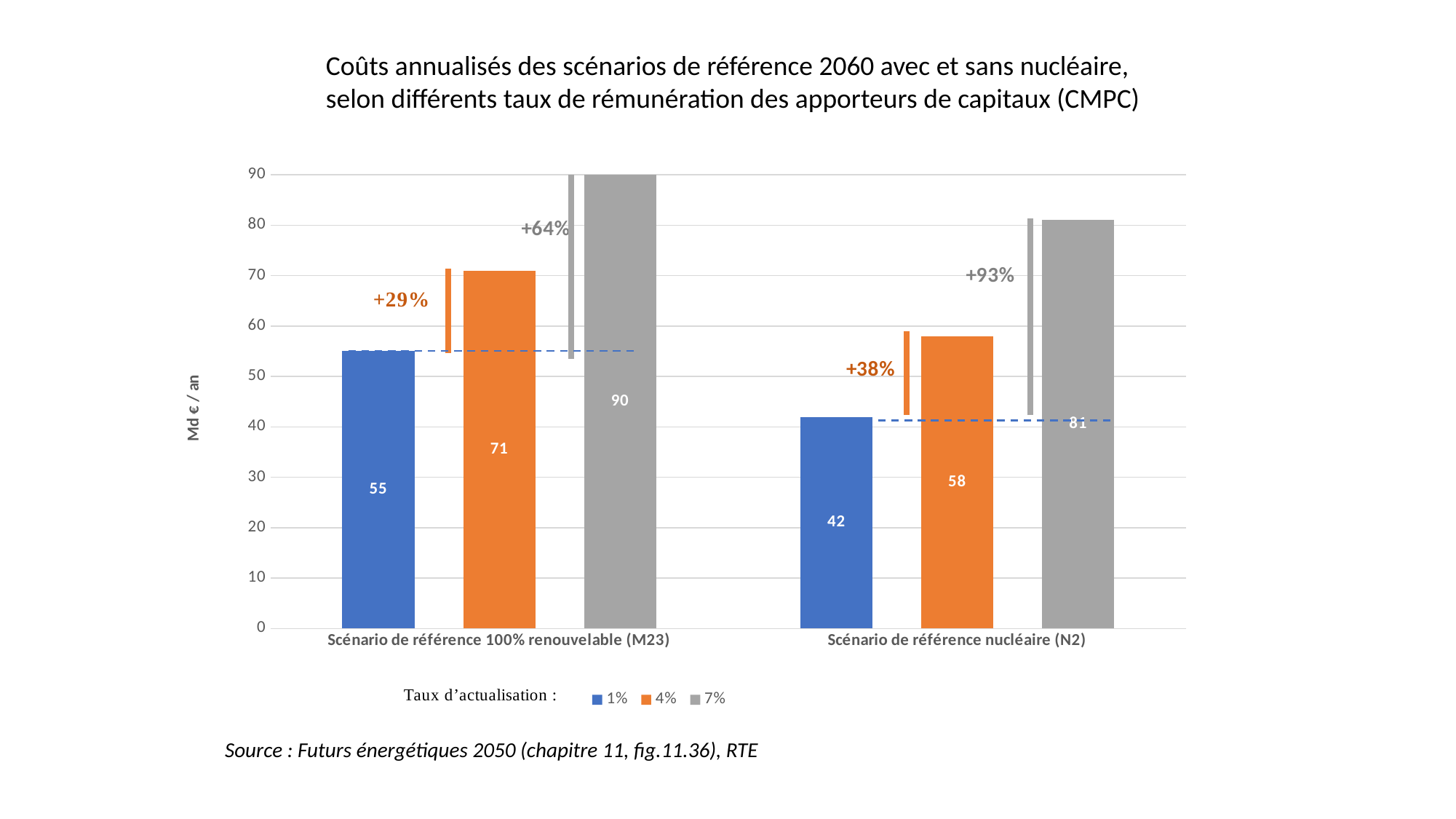
What is the unit shown on the y axis label? Md € / an What is the value for the 1% series in the 'Scénario de référence 100% renouvelable (M23)' category? 55 Which series has the highest value in the 'Scénario de référence 100% renouvelable (M23)' category? 7% How many series does the legend list? 3 What is the value for the 4% series in the 'Scénario de référence nucléaire (N2)' category? 58 What kind of chart is shown on the slide? bar chart What is the value for the 7% series in the 'Scénario de référence nucléaire (N2)' category? 81 What is the difference between the 7% and 1% values in the 'Scénario de référence 100% renouvelable (M23)' category? 35 Which series has the lowest value in the 'Scénario de référence nucléaire (N2)' category? 1% How many categories are shown on the x axis? 2 Which is larger: the 4% value for M23 or the 4% value for N2? 4% value for M23 Is the value for the 1% series in the 'Scénario de référence nucléaire (N2)' category greater or less than 50? less